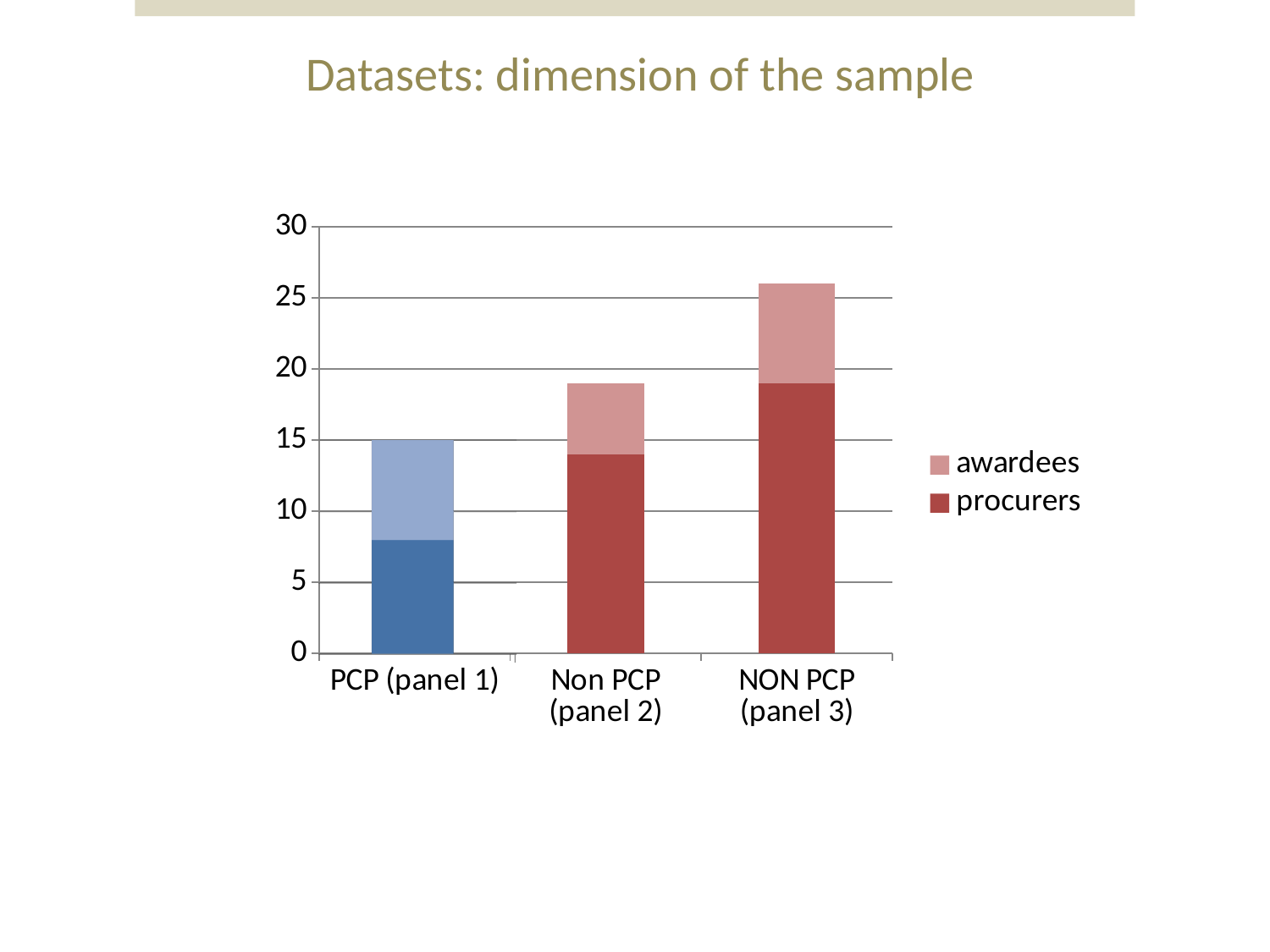
Which category has the shortest stacked bar? PCP (panel 1) What is the title of the slide containing the chart? Datasets: dimension of the sample Is the procurers value for PCP (panel 1) greater or less than 10? less How many categories are shown on the x axis of the chart? 3 Which is larger, the total for Non PCP (panel 2) or the total for NON PCP (panel 3)? NON PCP (panel 3) What is the total height of the stacked bar for PCP (panel 1)? 15 Is the total for NON PCP (panel 3) greater or less than 25? greater Is the procurers value for Non PCP (panel 2) greater or less than 10? greater What kind of chart is shown on the slide? stacked bar chart Which category has the tallest stacked bar? NON PCP (panel 3) How many series does the chart's legend list? 2